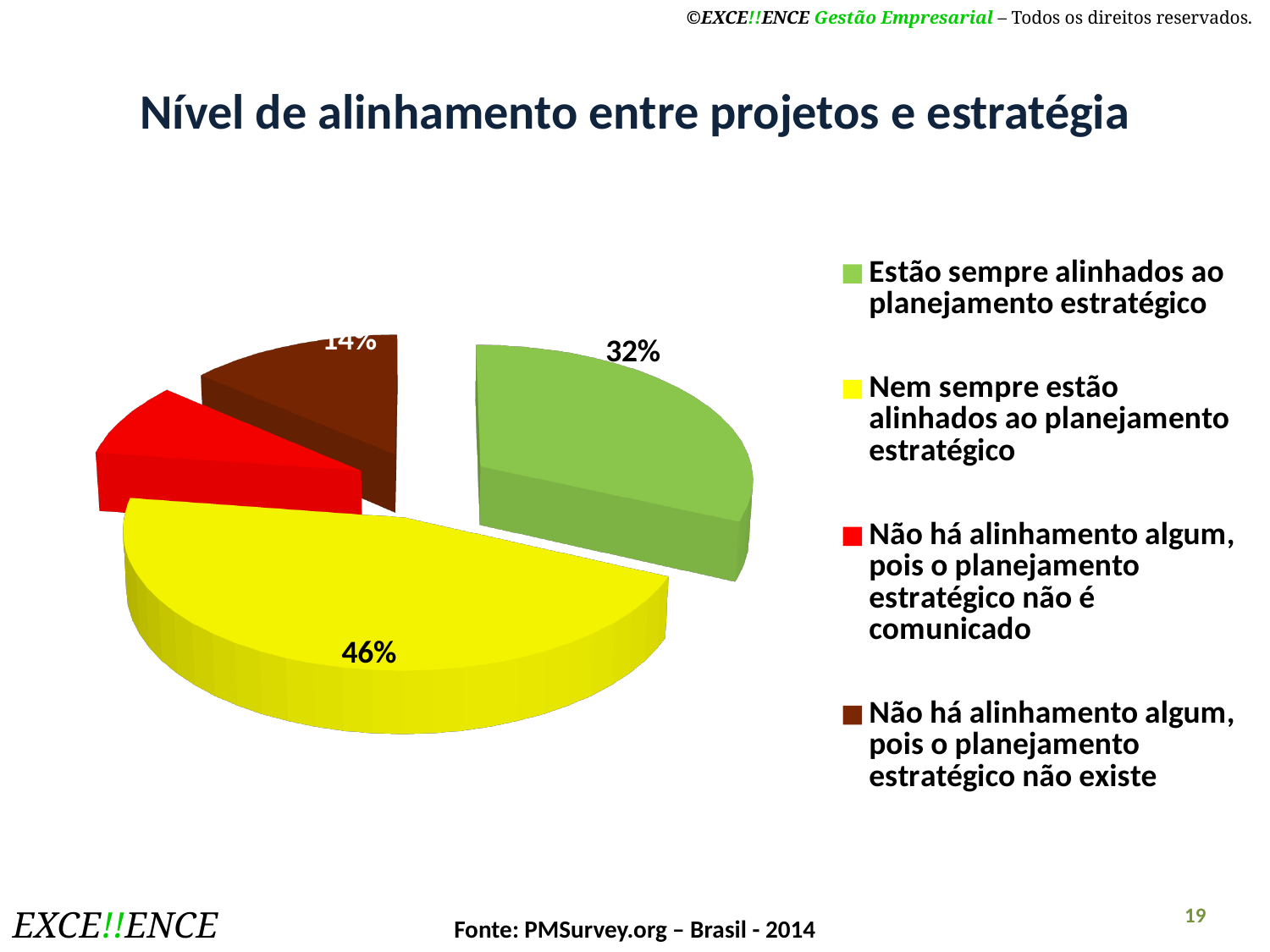
What kind of chart is shown on the slide? Pie chart By how many percentage points does the 46% slice exceed the 32% slice? 14 percentage points What percentage is shown for "Nem sempre estão alinhados ao planejamento estratégico"? 46% Which category has the largest slice of the pie? Nem sempre estão alinhados ao planejamento estratégico What percentage is shown for "Não há alinhamento algum, pois o planejamento estratégico não existe"? 14% Which category has the smallest slice of the pie? Não há alinhamento algum, pois o planejamento estratégico não é comunicado How many slices does the pie chart have? 4 What is the difference between the "Estão sempre alinhados ao planejamento estratégico" slice and the "Não há alinhamento algum, pois o planejamento estratégico não existe" slice? 18 percentage points How many entries does the legend list? 4 What colour represents "Nem sempre estão alinhados ao planejamento estratégico" in the chart? Yellow Which slice is larger: "Estão sempre alinhados ao planejamento estratégico" or "Nem sempre estão alinhados ao planejamento estratégico"? Nem sempre estão alinhados ao planejamento estratégico What percentage of the pie corresponds to "Estão sempre alinhados ao planejamento estratégico"? 32%